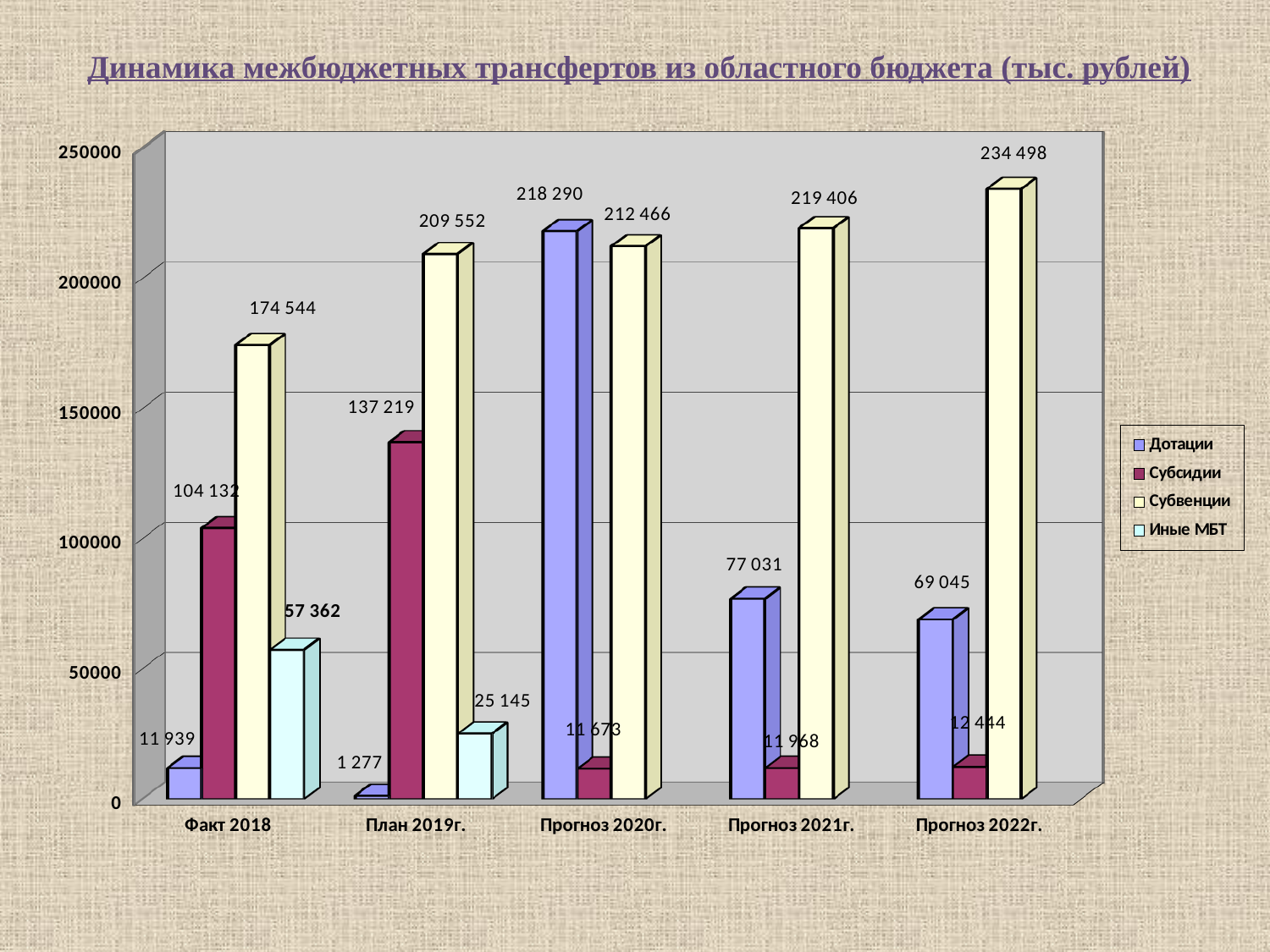
For Прогноз 2020г., which is larger: Дотации or Субвенции? Дотации In which category is the Субвенции value the highest? Прогноз 2022г. What kind of chart is shown on the slide? Bar chart What is the difference between the Субвенции values for Прогноз 2022г. and Прогноз 2021г.? 15 092 How many series does the legend list? 4 What is the value of Иные МБТ for План 2019г.? 25 145 In which category is the Дотации value the lowest? План 2019г. What is the value of Дотации for Факт 2018? 11 939 How many categories are shown on the x axis? 5 Do the Субвенции values rise or fall from Факт 2018 to Прогноз 2022г.? Rise What is the value of Субвенции for Прогноз 2022г.? 234 498 What is the difference between the Субсидии values for План 2019г. and Факт 2018? 33 087